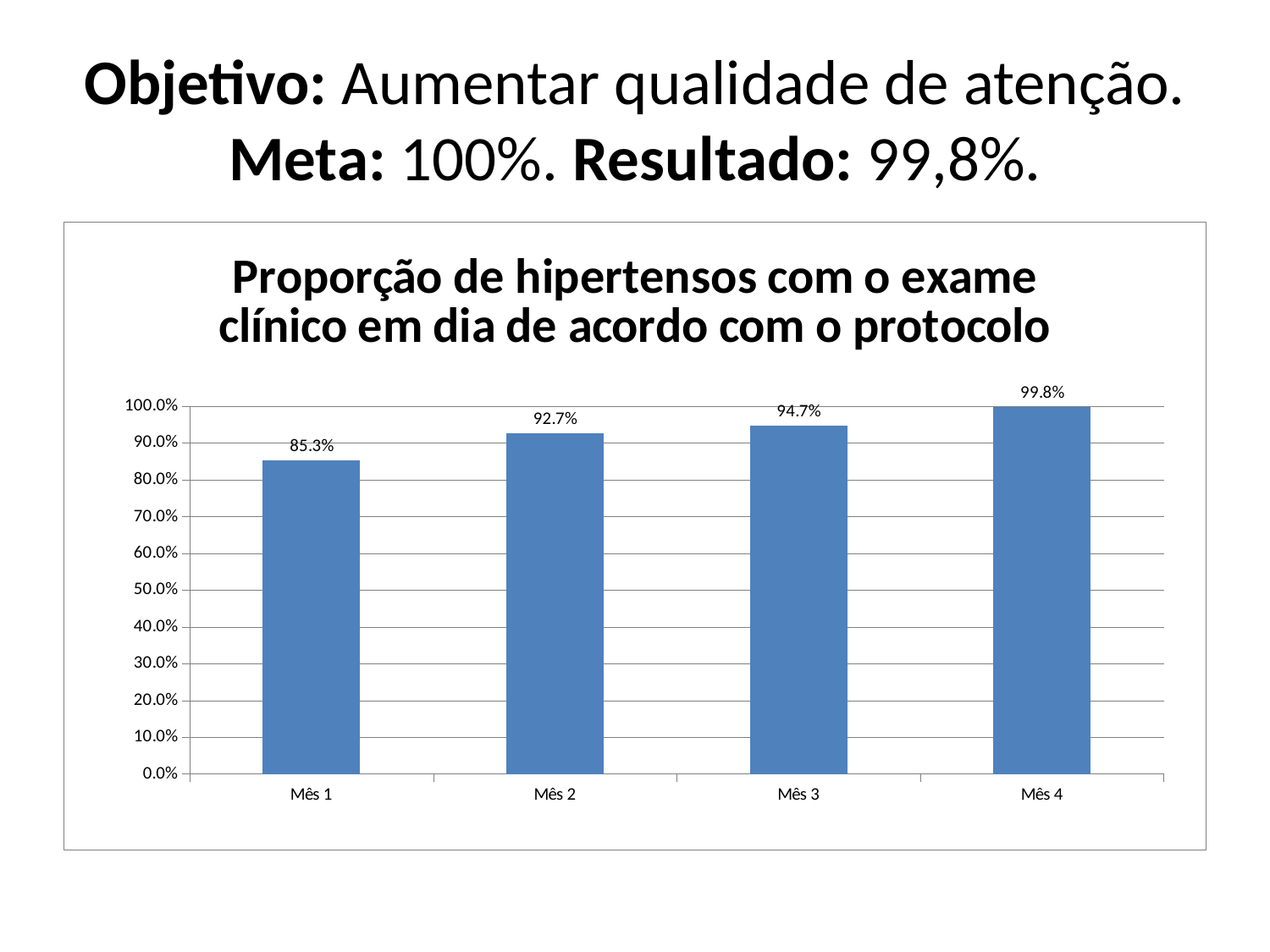
What is the value for Mês 1? 85.3% Which month has the lowest value? Mês 1 How many months are shown on the x axis? 4 Which month has the highest value? Mês 4 What is the difference between the values for Mês 4 and Mês 1? 14.5% Is the value for Mês 1 greater or less than 90.0%? less What kind of chart is shown on the slide? bar chart Do the values rise or fall from Mês 1 to Mês 4? rise What is the value for Mês 4? 99.8% What is the value for Mês 2? 92.7% What is the value for Mês 3? 94.7% Which is larger, the value for Mês 2 or the value for Mês 3? Mês 3